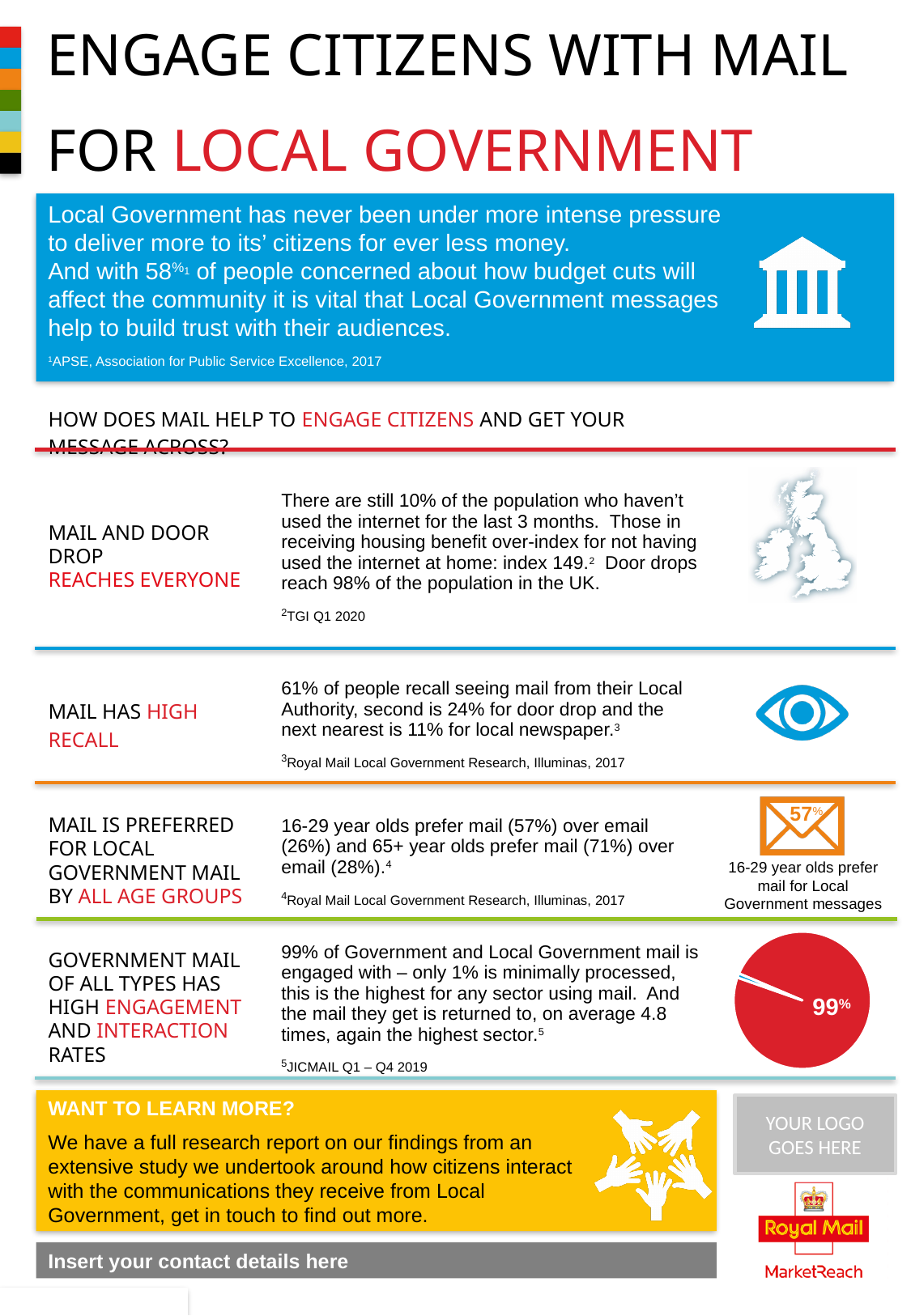
How many slices does the pie chart at the bottom right of the slide have? 2 What kind of chart is shown next to the 'Government mail of all types has high engagement and interaction rates' section? pie chart In the pie chart at the bottom right of the slide, which slice is larger, the red one or the blue one? the red one In the pie chart at the bottom right of the slide, what value is printed on the large slice? 99% What colour is the large slice in the pie chart at the bottom right of the slide? red In the pie chart at the bottom right of the slide, what share of the pie does the large red slice represent? 99% In the pie chart at the bottom right of the slide, is the value of the large slice greater or less than 50%? greater